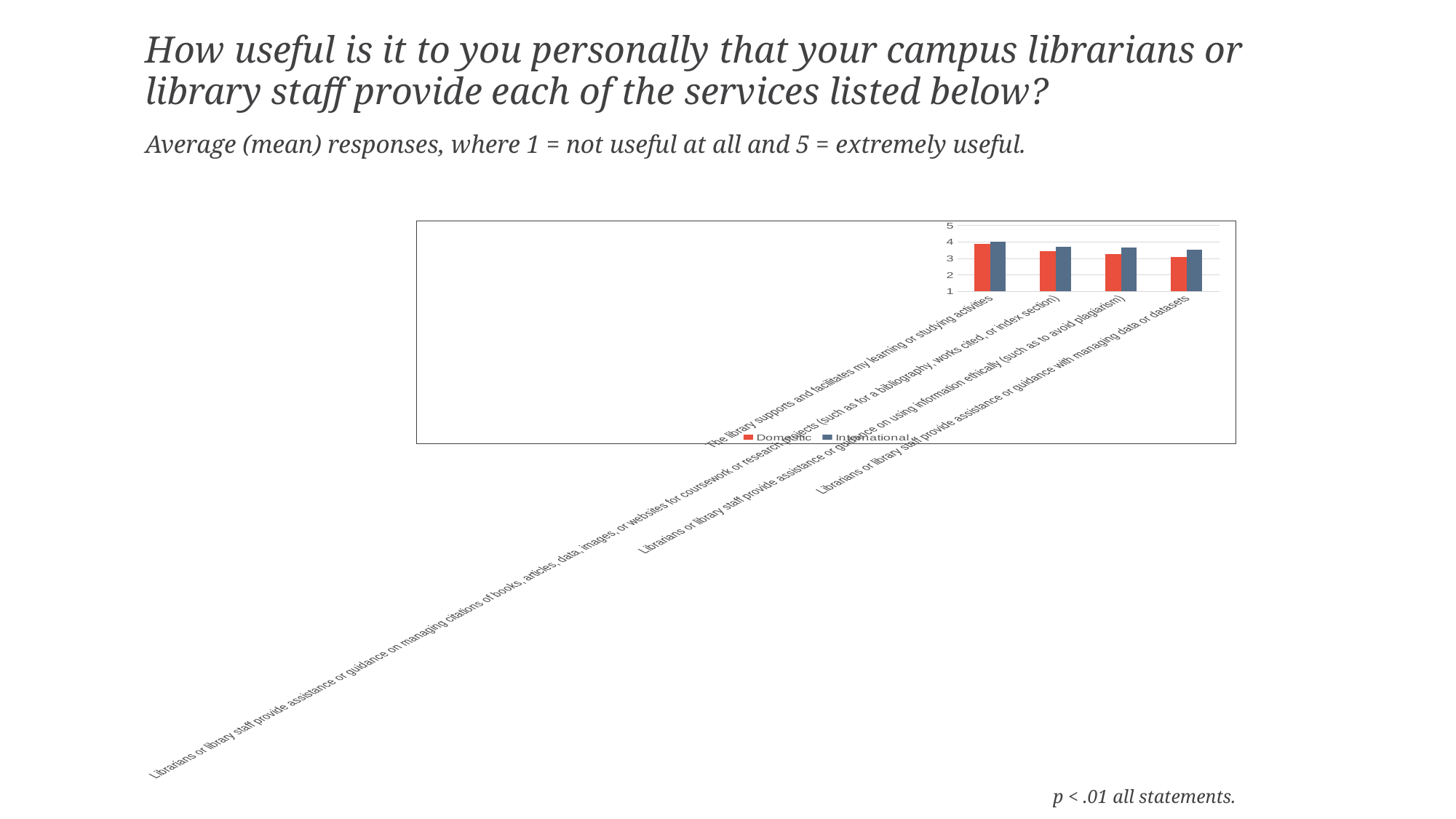
Which series is shown in red in the chart's legend? Domestic For 'Librarians or library staff provide assistance or guidance with managing data or datasets', which is larger: the Domestic or the International value? International Is the Domestic value for 'The library supports and facilitates my learning or studying activities' greater or less than 3? greater Is the Domestic value for 'Librarians or library staff provide assistance or guidance with managing data or datasets' greater or less than 4? less How many categories (statements) are plotted on the chart? 4 Which statement has the highest International value? The library supports and facilitates my learning or studying activities Is the International value for 'The library supports and facilitates my learning or studying activities' greater or less than 3? greater Do the Domestic values rise or fall moving from left to right across the categories? fall What kind of chart is shown on the slide? bar chart For 'Librarians or library staff provide assistance or guidance on using information ethically (such as to avoid plagiarism)', which is larger: the Domestic or the International value? International Which statement has the lowest Domestic value? Librarians or library staff provide assistance or guidance with managing data or datasets How many series does the chart's legend list? 2